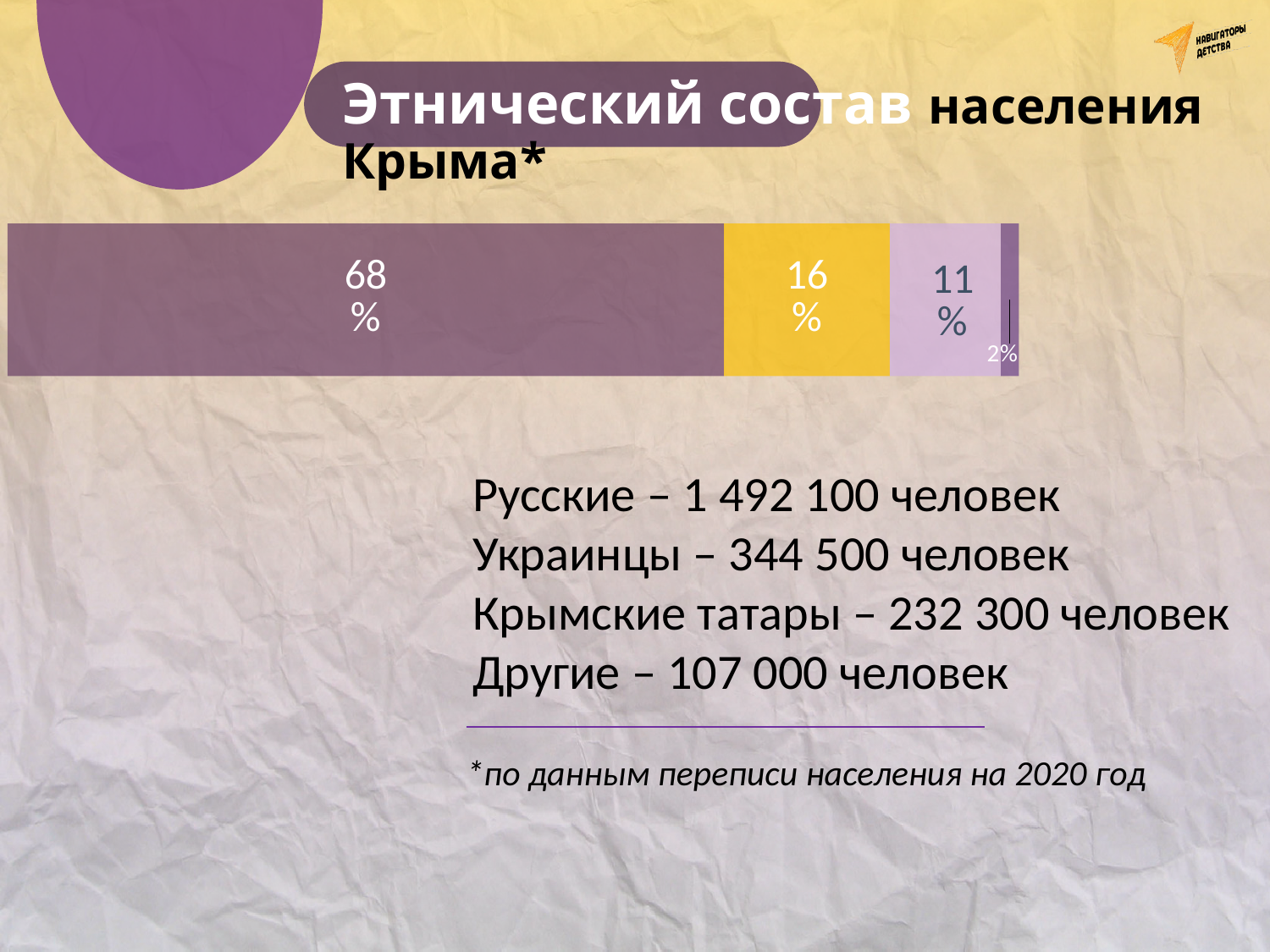
What value is printed on the light lilac segment of the bar? 11% What value is printed on the yellow segment of the bar? 16% What is the value of the smallest segment of the bar? 2% Which segment is larger, the yellow one or the light lilac one? The yellow one (16%) How many segments does the stacked bar contain? 4 What is the value of the largest segment of the bar? 68% What kind of chart is shown on the slide? Stacked horizontal bar chart What is the difference between the yellow segment (16%) and the light lilac segment (11%)? 5 percentage points What is the difference between the largest segment (68%) and the yellow segment (16%)? 52 percentage points What is the title of the slide containing the chart? Этнический состав населения Крыма* What value is printed on the leftmost (dark purple) segment of the bar? 68% What is the sum of the four percentages printed on the stacked bar? 97%